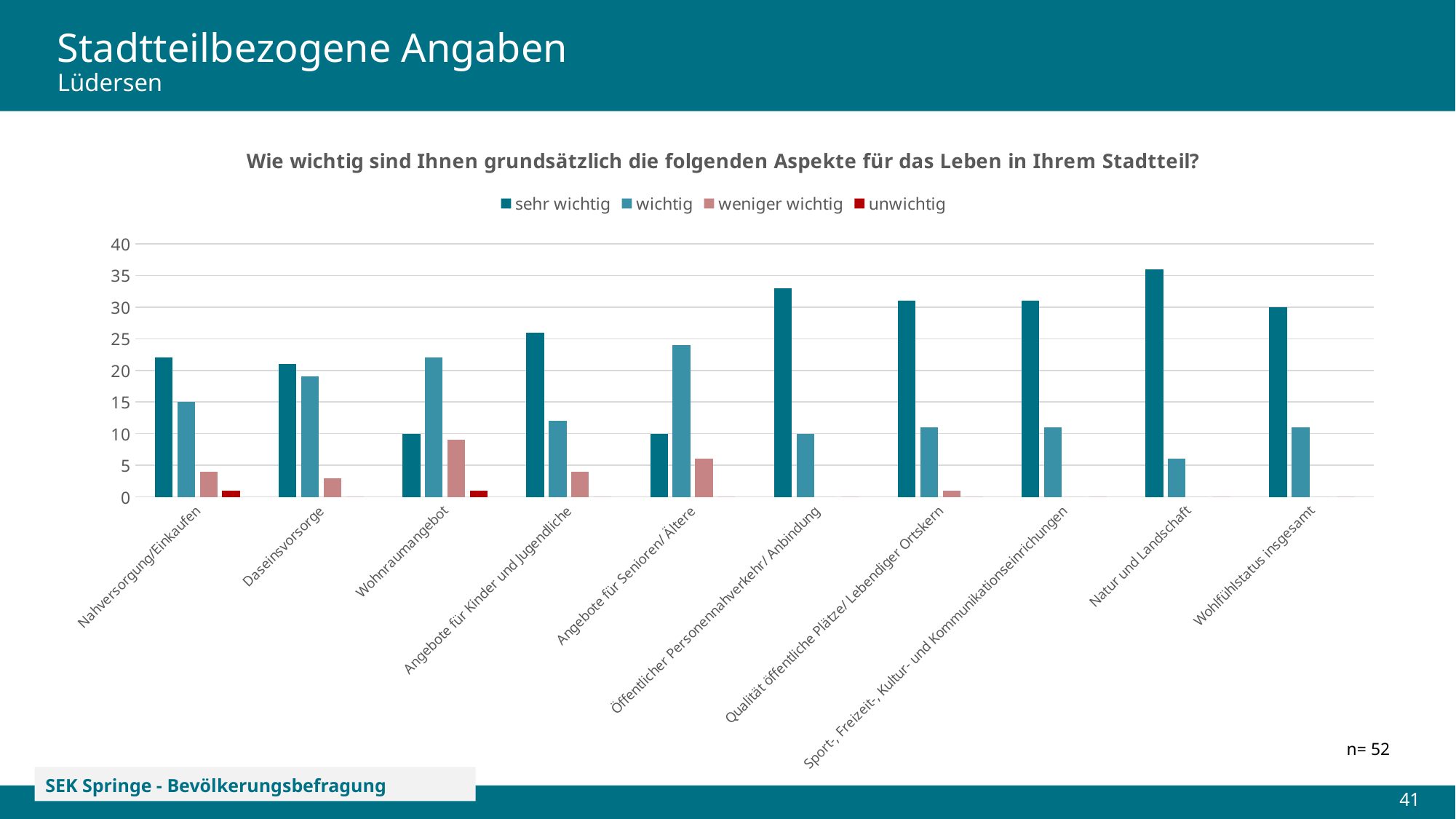
Is the 'sehr wichtig' value for Natur und Landschaft greater or less than 35? greater Is the 'sehr wichtig' value for Öffentlicher Personennahverkehr/ Anbindung greater or less than 30? greater Which category has the highest 'sehr wichtig' bar? Natur und Landschaft Which is larger for Wohnraumangebot: the 'sehr wichtig' bar or the 'wichtig' bar? wichtig Is the 'wichtig' value for Natur und Landschaft greater or less than 10? less How many series does the legend list? 4 What kind of chart is shown on the slide? bar chart How many categories are shown on the x axis? 10 Which legend entry is shown in red? unwichtig Which is larger for Daseinsvorsorge: the 'sehr wichtig' bar or the 'wichtig' bar? sehr wichtig What is the title of the chart? Wie wichtig sind Ihnen grundsätzlich die folgenden Aspekte für das Leben in Ihrem Stadtteil?